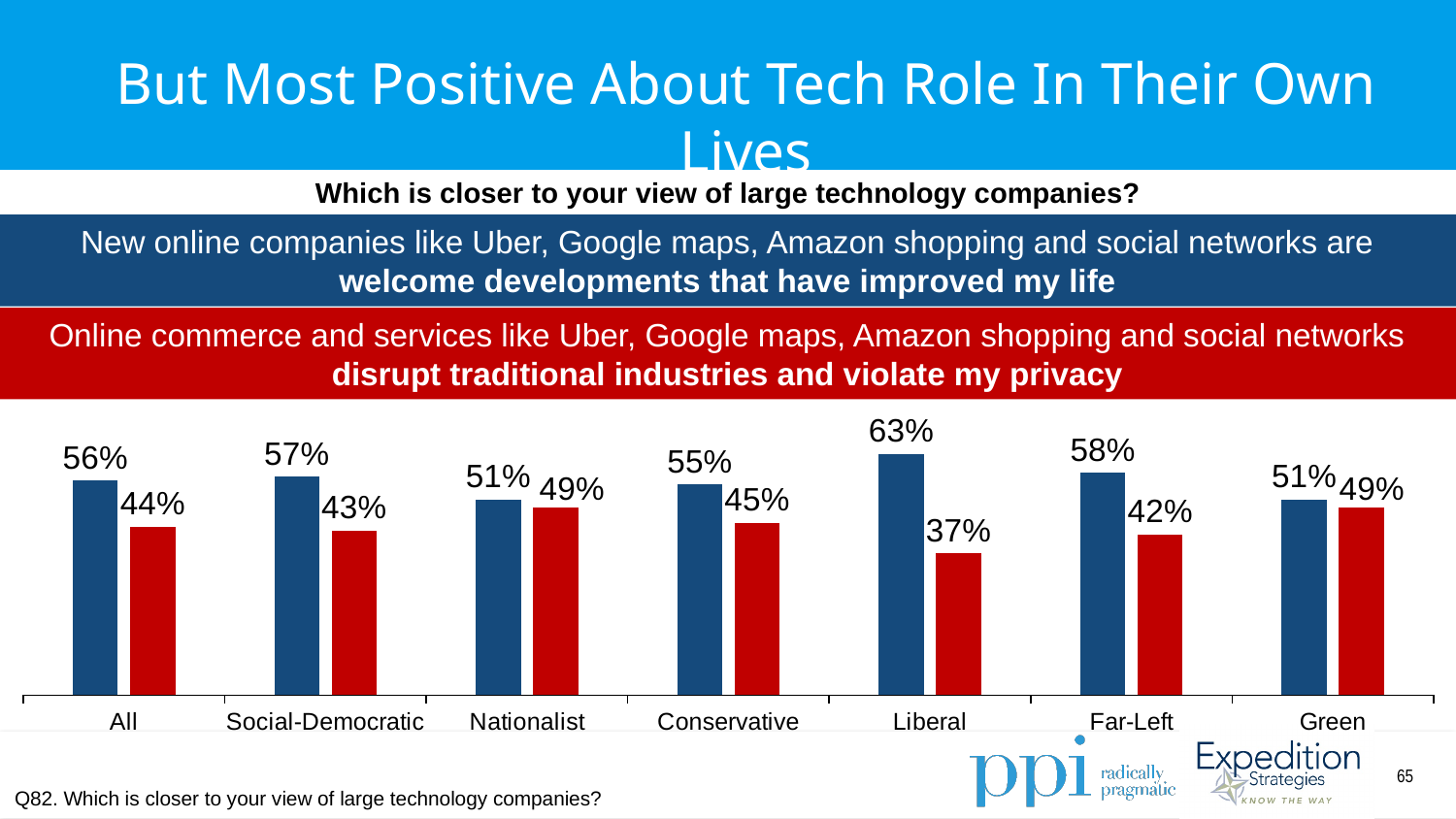
How many series does the chart plot for each category? 2 What percentage of Liberal respondents say new online companies are welcome developments that have improved their life (blue bar)? 63% What percentage of Nationalist respondents say online commerce and services disrupt traditional industries and violate their privacy (red bar)? 49% What kind of chart is shown on the slide? Bar chart What is the difference between the blue and red bars for Far-Left respondents? 16 percentage points Which is larger for Conservative respondents: the blue bar or the red bar? The blue bar (55%) What is the value of the blue bar for the All category? 56% How many categories are shown along the x axis of the chart? 7 Which category has the highest blue bar (welcome developments)? Liberal Which two categories share the same values of 51% and 49%? Nationalist and Green Which category has the lowest red bar (disrupt traditional industries and violate my privacy)? Liberal What is the red bar value for Social-Democratic respondents? 43%